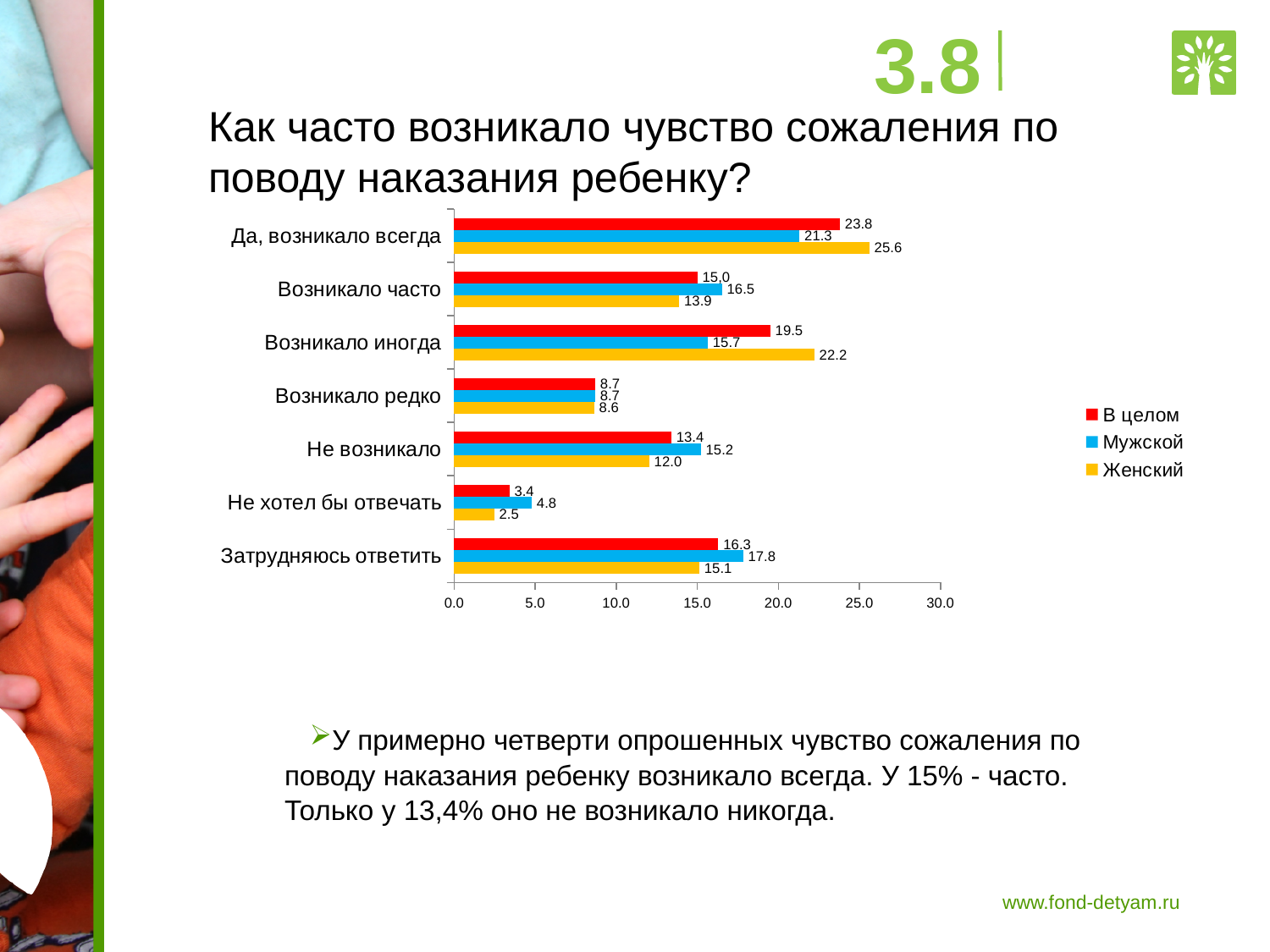
Which colour represents the "Женский" series in the chart? Yellow How many categories are shown on the chart? 7 In the category "Не возникало", which is larger: the "Мужской" value or the "Женский" value? Мужской What is the value for "Мужской" in the category "Не хотел бы отвечать"? 4.8 Which category has the highest value for the "Женский" series? Да, возникало всегда Which category has the lowest value for the "В целом" series? Не хотел бы отвечать Is the "В целом" value for "Возникало иногда" greater or less than 15.0? greater How many series does the legend list? 3 What type of chart is shown on the slide? Bar chart What is the value for "Женский" in the category "Возникало иногда"? 22.2 What is the value for "В целом" in the category "Да, возникало всегда"? 23.8 What is the difference between the "Женский" and "Мужской" values in the category "Да, возникало всегда"? 4.3